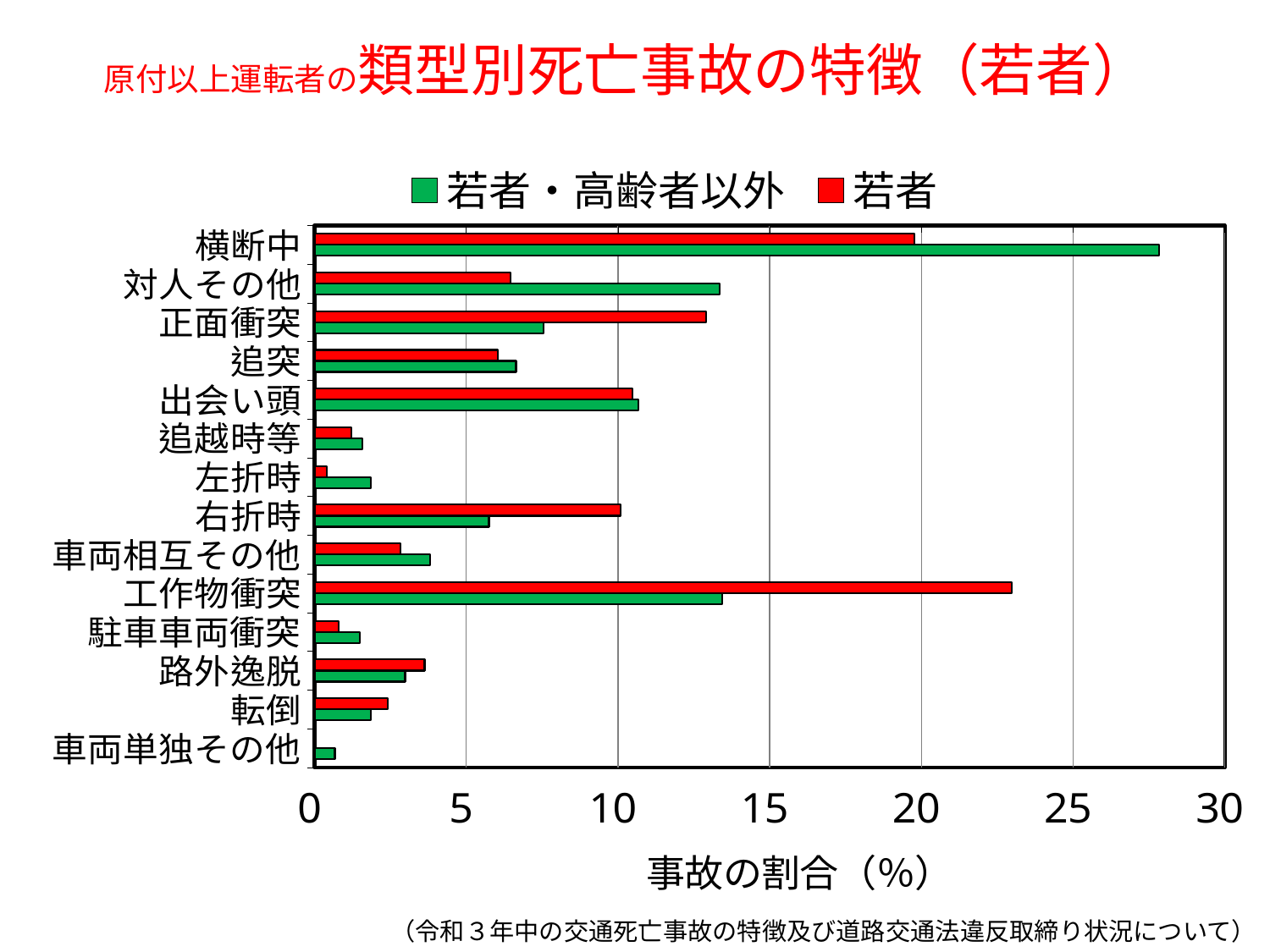
What colour represents the 若者 series in the legend? red Which category has the highest value for the 若者・高齢者以外 series? 横断中 For 横断中, which series has the larger value, 若者 or 若者・高齢者以外? 若者・高齢者以外 Which category has the highest value for the 若者 series? 工作物衝突 Which category has the lowest value for the 若者 series? 車両単独その他 How many accident-type categories are plotted on the chart? 14 Is the 若者 value for 工作物衝突 greater or less than 20? greater Is the 若者・高齢者以外 value for 横断中 greater or less than 25? greater What kind of chart is shown on the slide? bar chart Is the 若者 value for 左折時 greater or less than 5? less For 工作物衝突, which series has the larger value, 若者 or 若者・高齢者以外? 若者 How many series does the legend list? 2